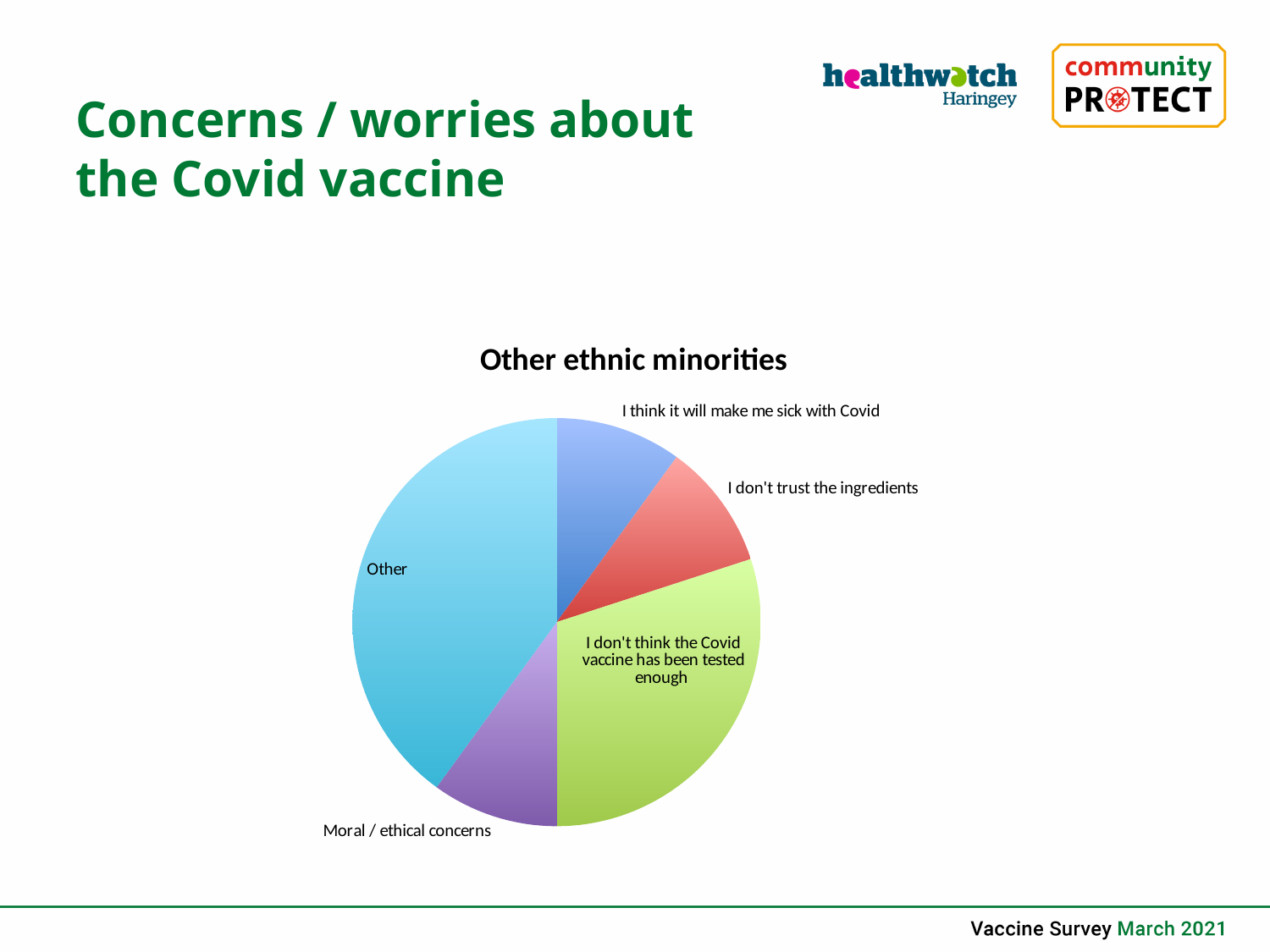
Which slice of the pie chart is the largest? Other Which is larger in the pie chart: "Other" or "Moral / ethical concerns"? Other Which slice of the pie chart is the second largest? I don't think the Covid vaccine has been tested enough What colour is the "Other" slice in the pie chart? Light blue Which is larger in the pie chart: "I don't think the Covid vaccine has been tested enough" or "I don't trust the ingredients"? I don't think the Covid vaccine has been tested enough What is the title of the pie chart? Other ethnic minorities Which is larger in the pie chart: "I think it will make me sick with Covid" or "Other"? Other What kind of chart is shown on the slide? Pie chart How many slices does the pie chart have? 5